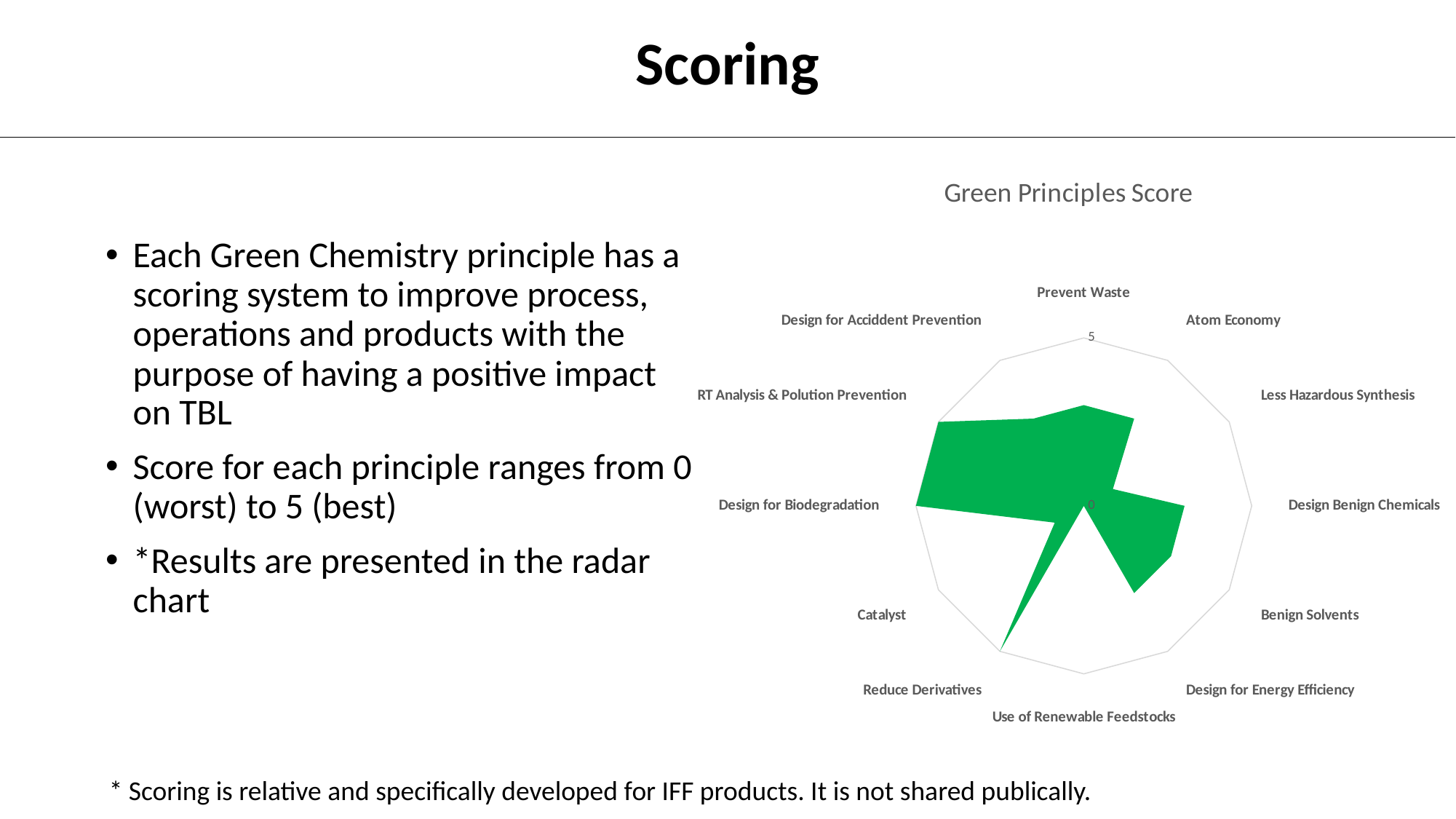
Which has the larger value, RT Analysis & Polution Prevention or Atom Economy? RT Analysis & Polution Prevention Which has the larger value, Reduce Derivatives or Catalyst? Reduce Derivatives Is the value for Prevent Waste greater or less than 5? less Is the value for Catalyst greater or less than 5? less What is the maximum value shown on the radar chart's axis? 5 Which has the larger value, Design for Biodegradation or Less Hazardous Synthesis? Design for Biodegradation What kind of chart is shown on the slide? Radar chart What is the title of the chart? Green Principles Score How many principles (categories) are plotted on the radar chart? 12 Is the value for Less Hazardous Synthesis greater or less than 5? less